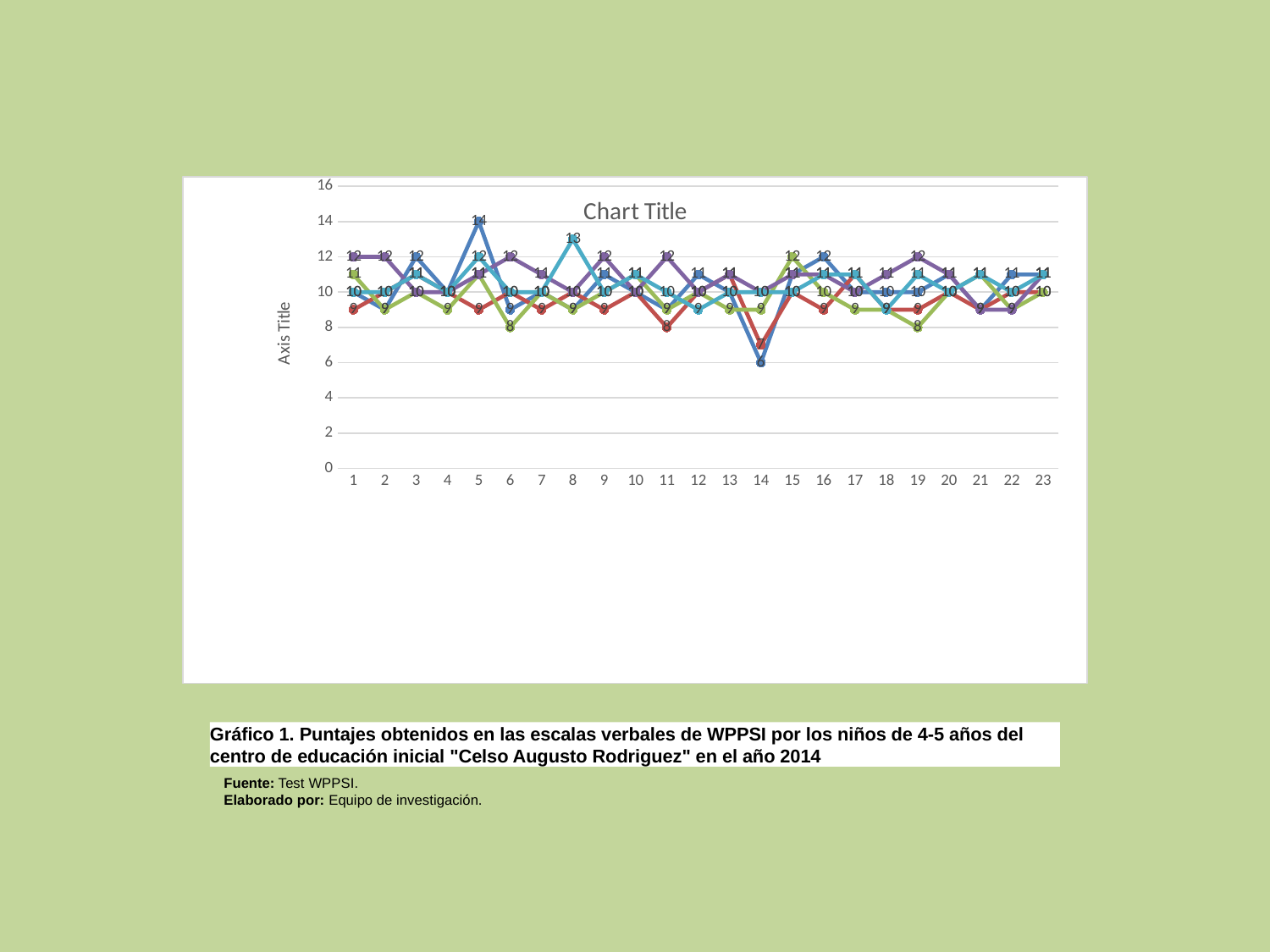
What is the title of the vertical axis of the chart? Axis Title What is the highest value plotted on the chart? 14 What is the title printed on the chart? Chart Title What is the lowest value plotted on the chart? 6 What is the highest value plotted at category 8? 13 At which x-axis category does the lowest plotted value (6) occur? 14 Is the highest value plotted at category 5 greater or less than 12? greater What kind of chart is shown on the slide? line chart How many categories are shown along the x axis of the chart? 23 Is the lowest value plotted at category 14 greater or less than 8? less What is the difference between the highest plotted value (14) and the lowest plotted value (6)? 8 At which x-axis category does the highest plotted value (14) occur? 5